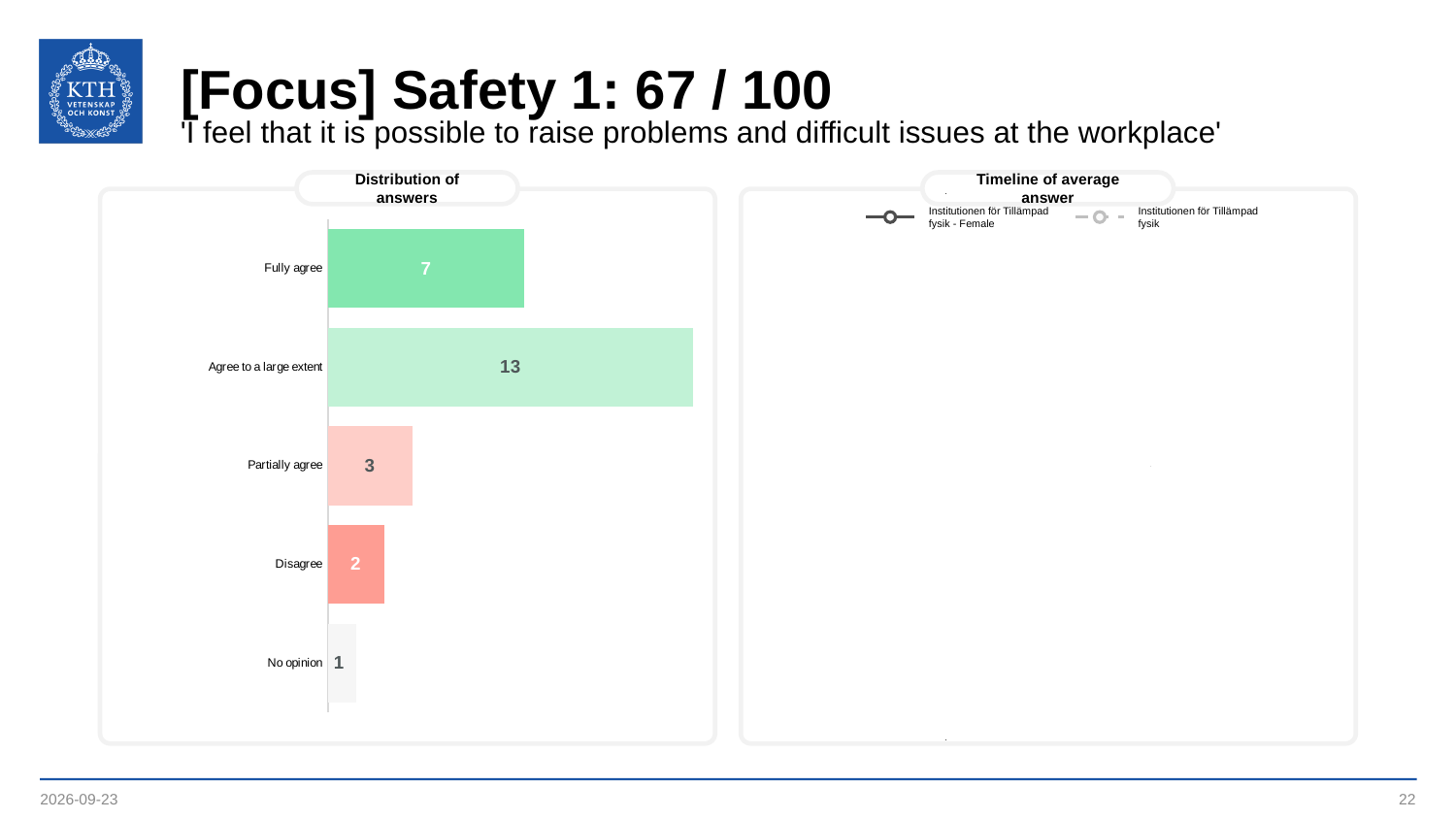
What kind of chart is the 'Distribution of answers' chart? Bar chart In the 'Distribution of answers' chart, which answer category has the highest value? Agree to a large extent In the 'Distribution of answers' chart, which answer category has the lowest value? No opinion In the 'Distribution of answers' chart, what is the total number of answers across all five categories? 26 How many series does the legend of the 'Timeline of average answer' chart list? 2 In the 'Distribution of answers' chart, what is the value for 'Fully agree'? 7 In the 'Distribution of answers' chart, how many respondents chose 'Agree to a large extent'? 13 In the 'Distribution of answers' chart, what is the difference between 'Agree to a large extent' and 'Fully agree'? 6 In the 'Distribution of answers' chart, what is the value for 'Partially agree'? 3 In the 'Distribution of answers' chart, what is the value for 'No opinion'? 1 How many answer categories are shown in the 'Distribution of answers' chart? 5 In the 'Distribution of answers' chart, which is larger: 'Partially agree' or 'Disagree'? Partially agree